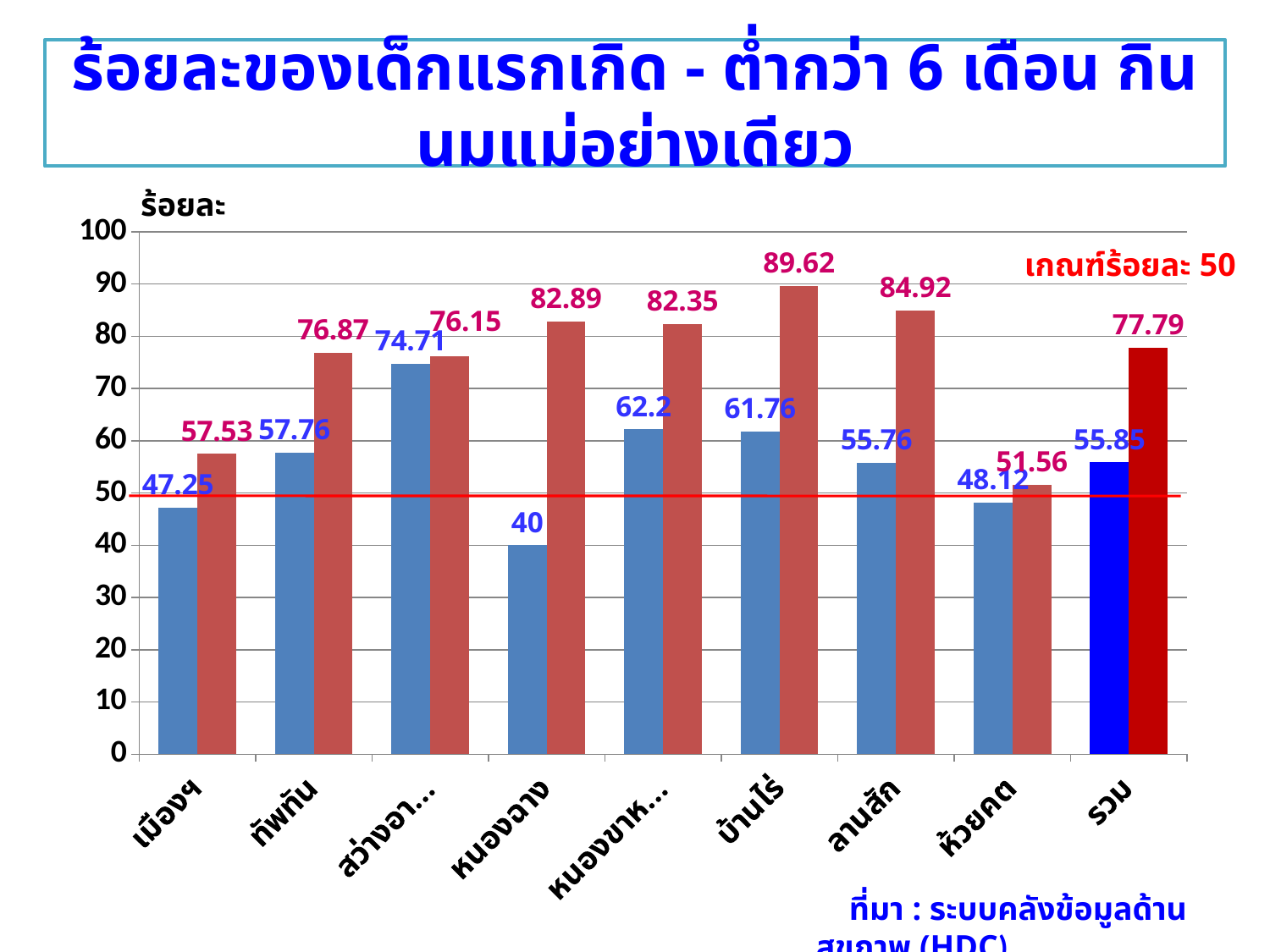
What is the value of the blue bar for ลานสัก? 55.76 Which category has the lowest red bar? ห้วยคต Which is larger for ทัพทัน, the blue bar or the red bar? the red bar What is the difference between the red bar and the blue bar for หนองฉาง? 42.89 What kind of chart is shown on the slide? bar chart Is the blue bar for เมืองฯ greater or less than 50? less Which category has the highest red bar? บ้านไร่ What is the value of the red bar for บ้านไร่? 89.62 Which category has the lowest blue bar? หนองฉาง What is the value of the blue bar for หนองฉาง? 40 How many categories are shown on the x axis? 9 What is the value of the red bar for รวม? 77.79